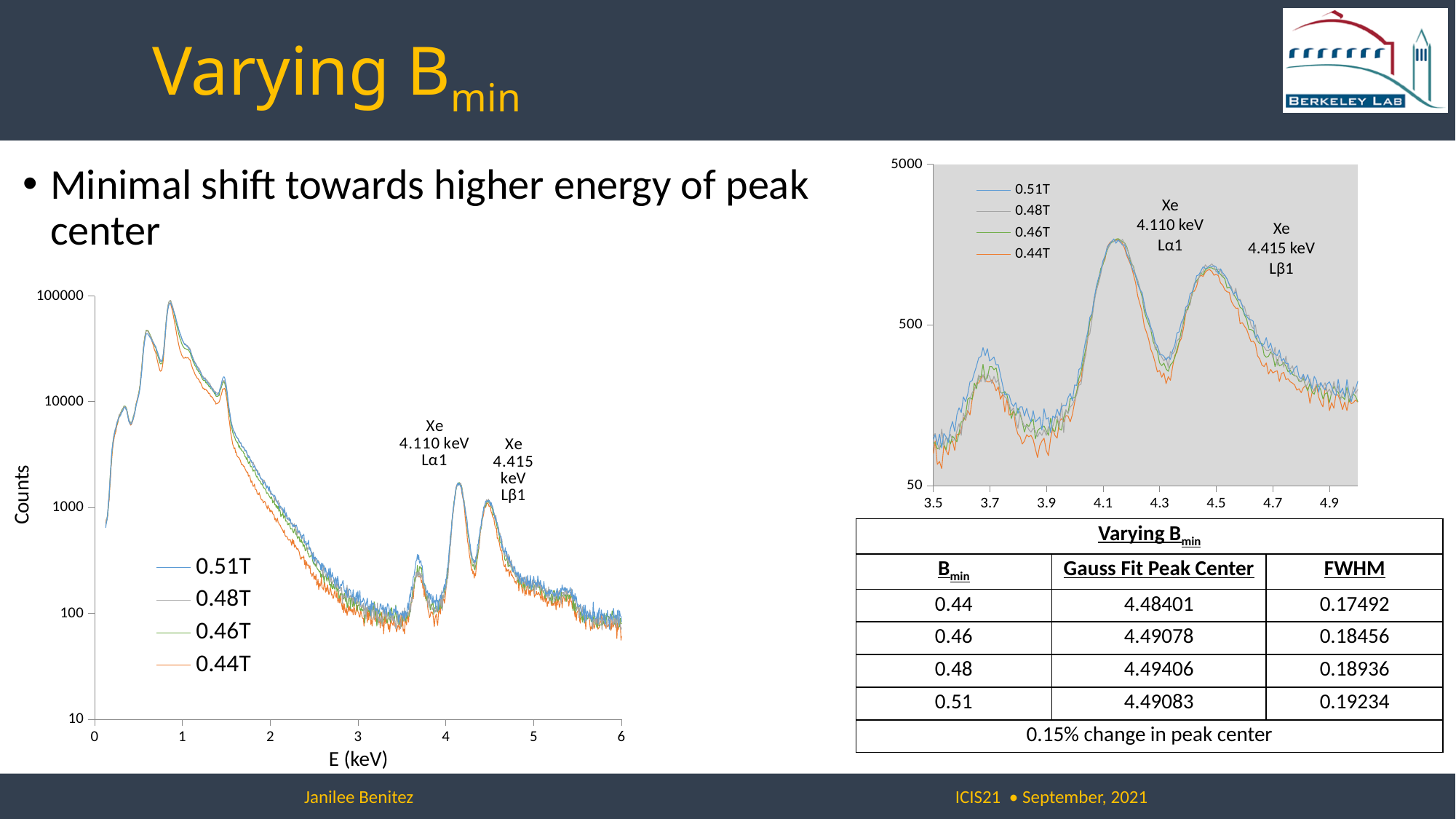
On the right chart, is the peak value near 4.15 keV greater or less than 500? greater On the left chart, what is the label of the x axis? E (keV) On the left chart, is the peak value near 0.9 keV greater or less than 10000 counts? greater On the left chart, how many series does the legend list? 4 On the left chart, is the value at 3 keV greater or less than 1000 counts? less On the left chart, what kind of chart is shown? line chart On the right chart, how many series does the legend list? 4 On the left chart, what is the label of the y axis? Counts On the left chart, which Xe line is labelled at 4.110 keV? Lα1 On the right chart, how many tick labels are shown on the x axis? 8 On the left chart, do the counts rise or fall as energy increases from 1.5 keV to 3 keV? fall